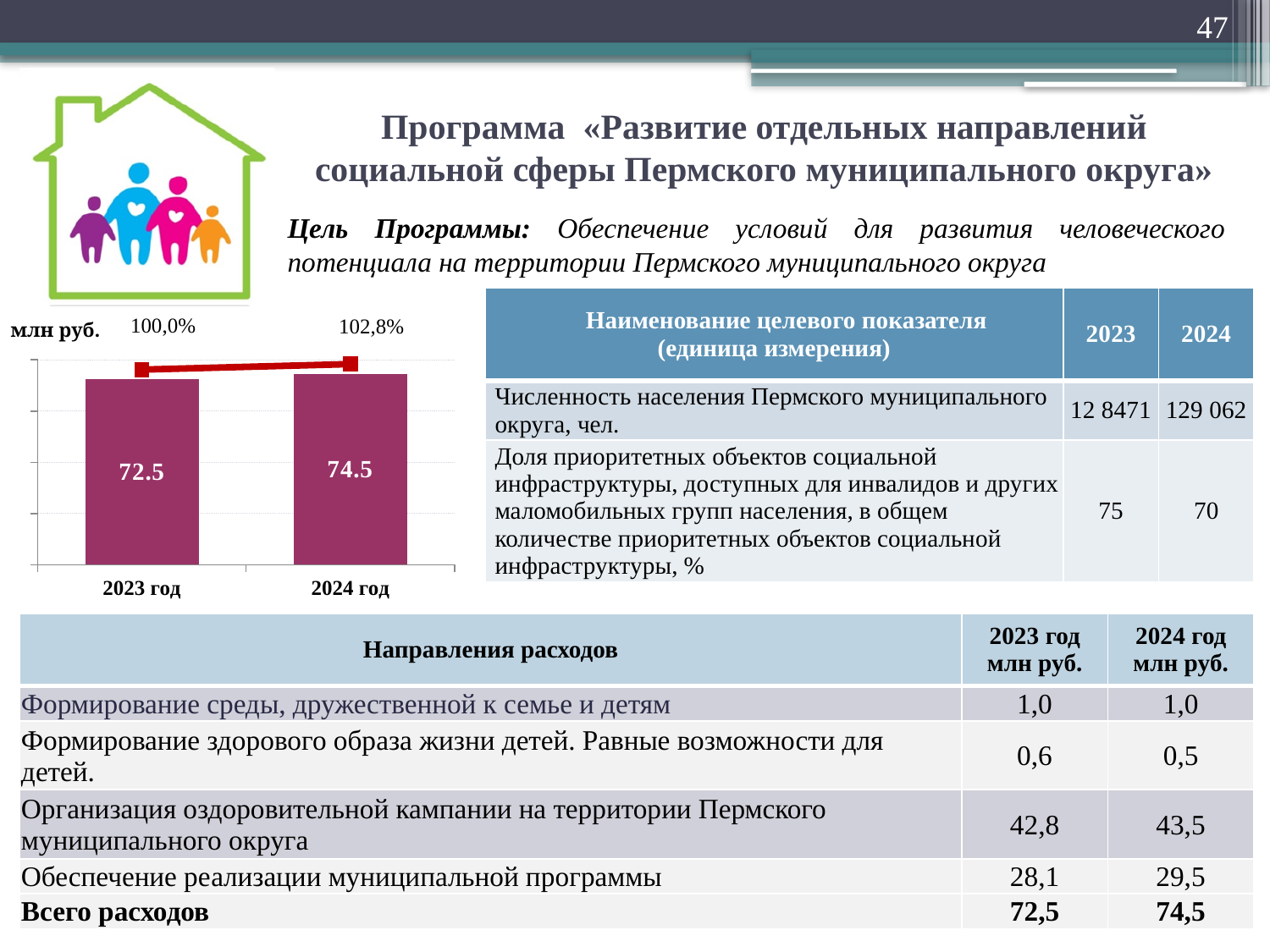
Do the bar values rise or fall from 2023 год to 2024 год? rise What unit is indicated at the top left of the chart? млн руб. Which year has the lower bar in the chart? 2023 год What is the difference between the bar values for 2024 год and 2023 год? 2.0 How many bars are plotted in the chart? 2 What percentage label is shown above the 2024 год bar on the line? 102,8% What kind of chart is shown on the slide? combination bar and line chart Which year has the higher bar in the chart? 2024 год What percentage label is shown above the 2023 год bar on the line? 100,0% Is the bar for 2024 год larger or smaller than the bar for 2023 год? larger What is the value of the bar for 2024 год in the chart? 74.5 What is the value of the bar for 2023 год in the chart? 72.5